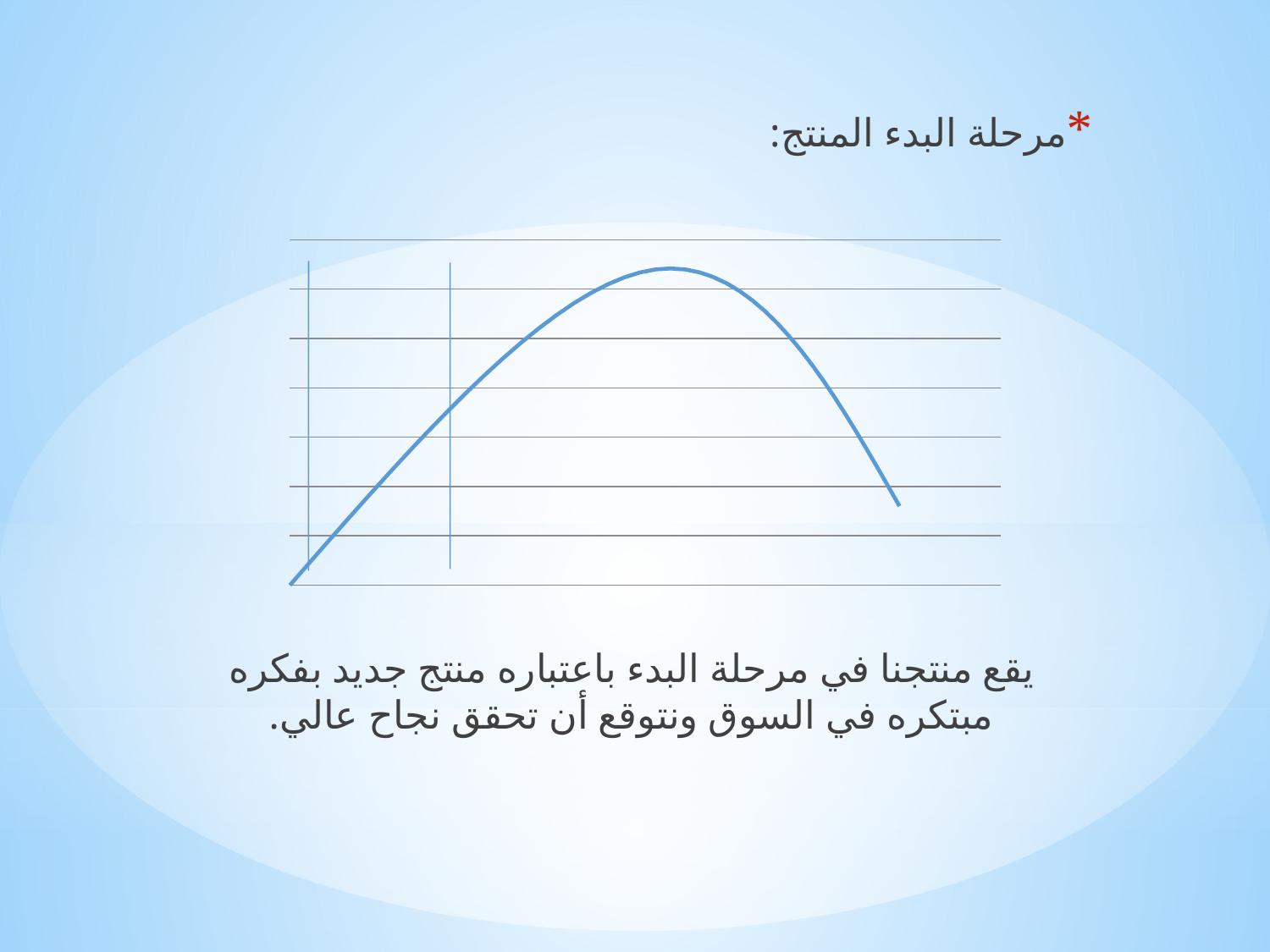
What kind of chart is shown on the slide? line chart What colour is the plotted line on the chart? blue How many lines are plotted on the chart? 1 Does the plotted line rise or fall over the left half of the chart? rises How does the plotted line behave from left to right along the x axis? rises then falls Does the plotted line rise or fall over the right half of the chart? falls